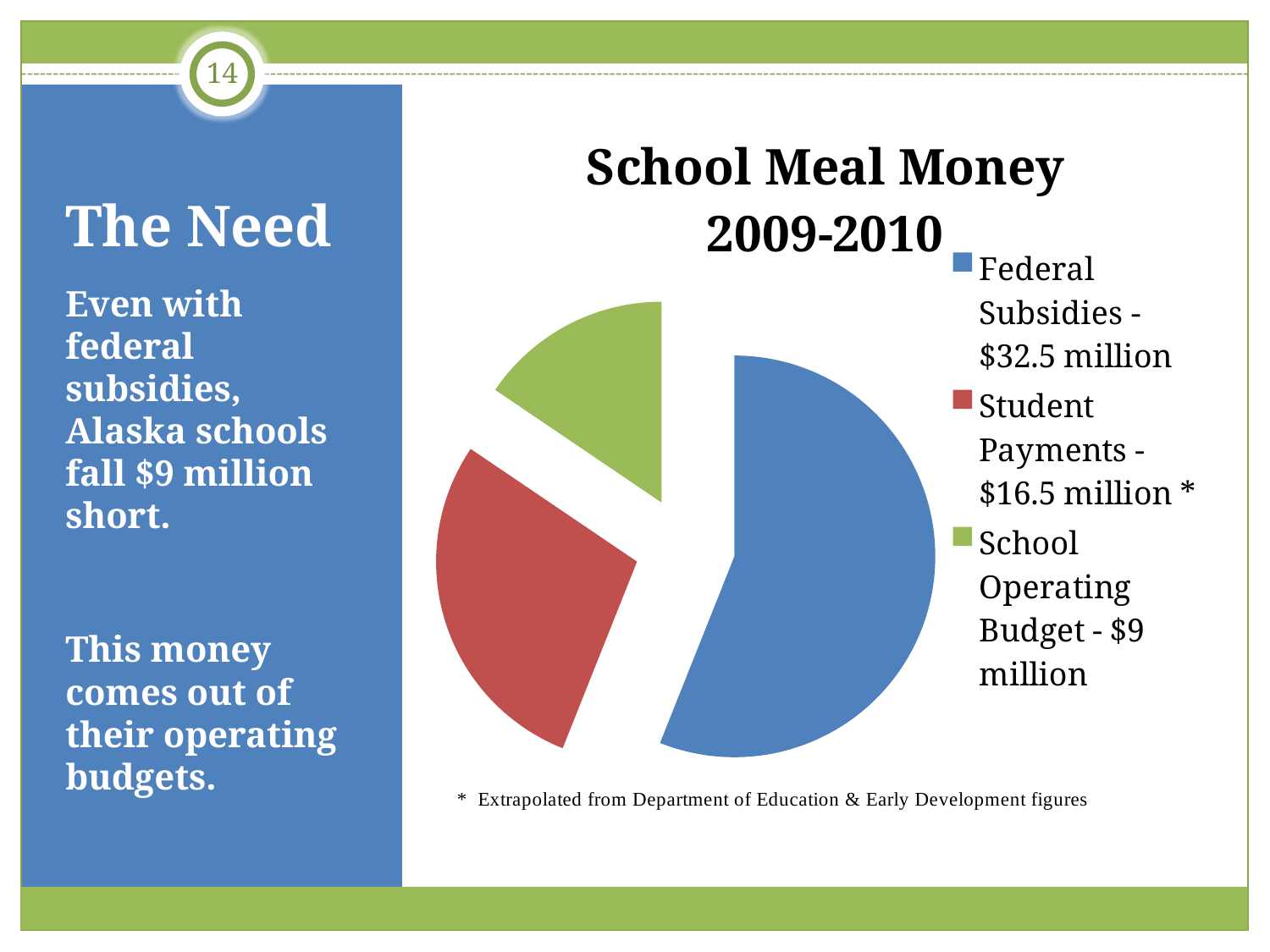
Which category has the smallest slice of the pie? School Operating Budget What colour is the Federal Subsidies slice? Blue How many slices does the pie chart have? 3 Which category has the largest slice of the pie? Federal Subsidies What is the difference between Student Payments and School Operating Budget? $7.5 million Which is larger, Student Payments or School Operating Budget? Student Payments What is the value for School Operating Budget? $9 million What is the title of the chart? School Meal Money 2009-2010 What is the difference between Federal Subsidies and Student Payments? $16 million What is the value for Student Payments? $16.5 million What is the value for Federal Subsidies? $32.5 million What type of chart is shown on the slide? Pie chart